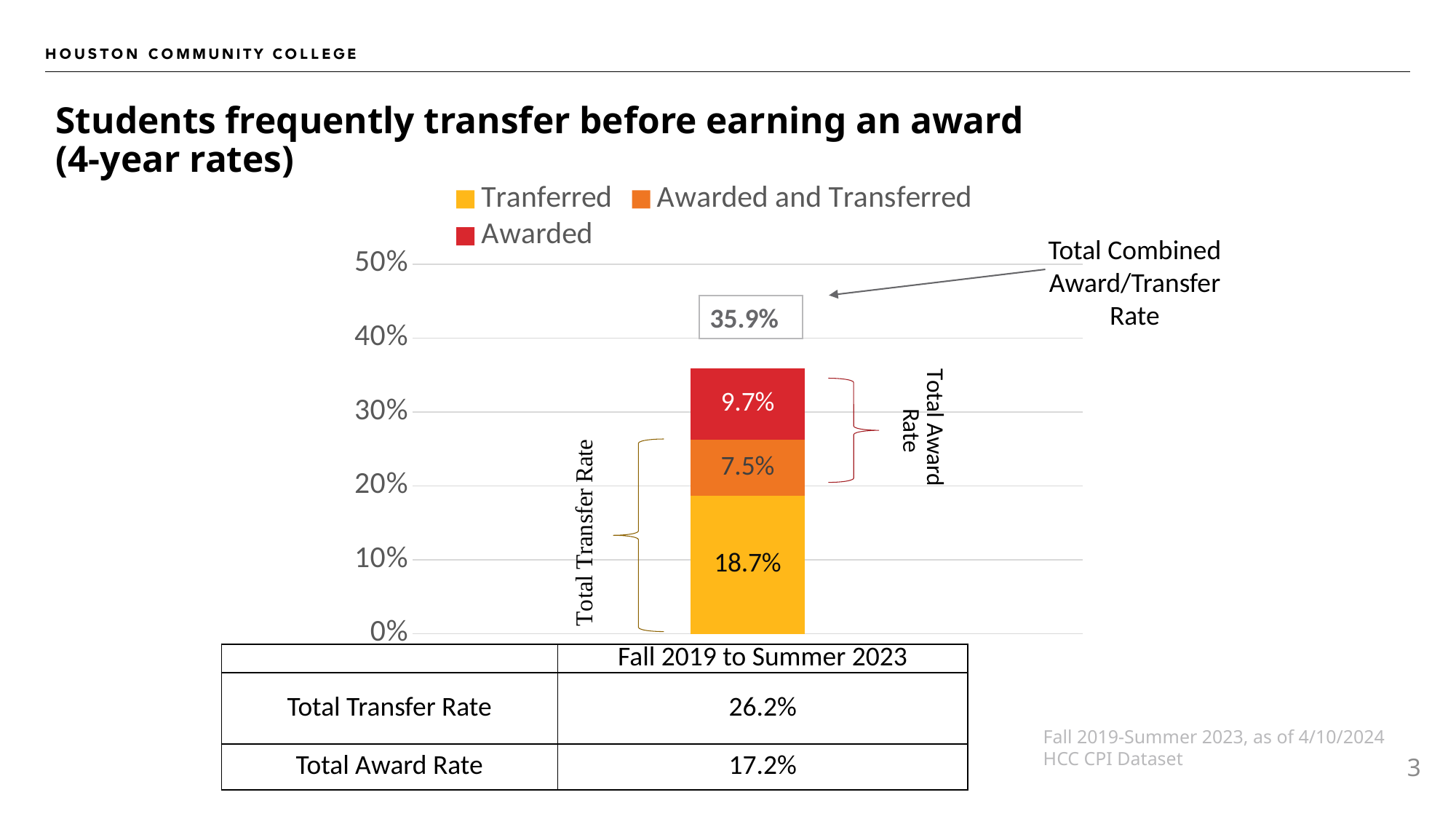
How many series does the legend list? 3 Which is larger, the Awarded segment or the Awarded and Transferred segment? Awarded Which segment of the stacked bar has the smallest value? Awarded and Transferred Is the total height of the stacked bar greater or less than 40%? less What kind of chart is shown on the slide? Stacked bar chart What is the value of the Tranferred segment of the bar? 18.7% What is the difference between the Awarded segment and the Awarded and Transferred segment? 2.2% What is the value of the Awarded segment of the bar? 9.7% What is the value of the Awarded and Transferred segment of the bar? 7.5% What is the Total Combined Award/Transfer Rate shown above the bar? 35.9% Which segment of the stacked bar has the largest value? Tranferred What is the Total Transfer Rate shown in the table below the chart for Fall 2019 to Summer 2023? 26.2%